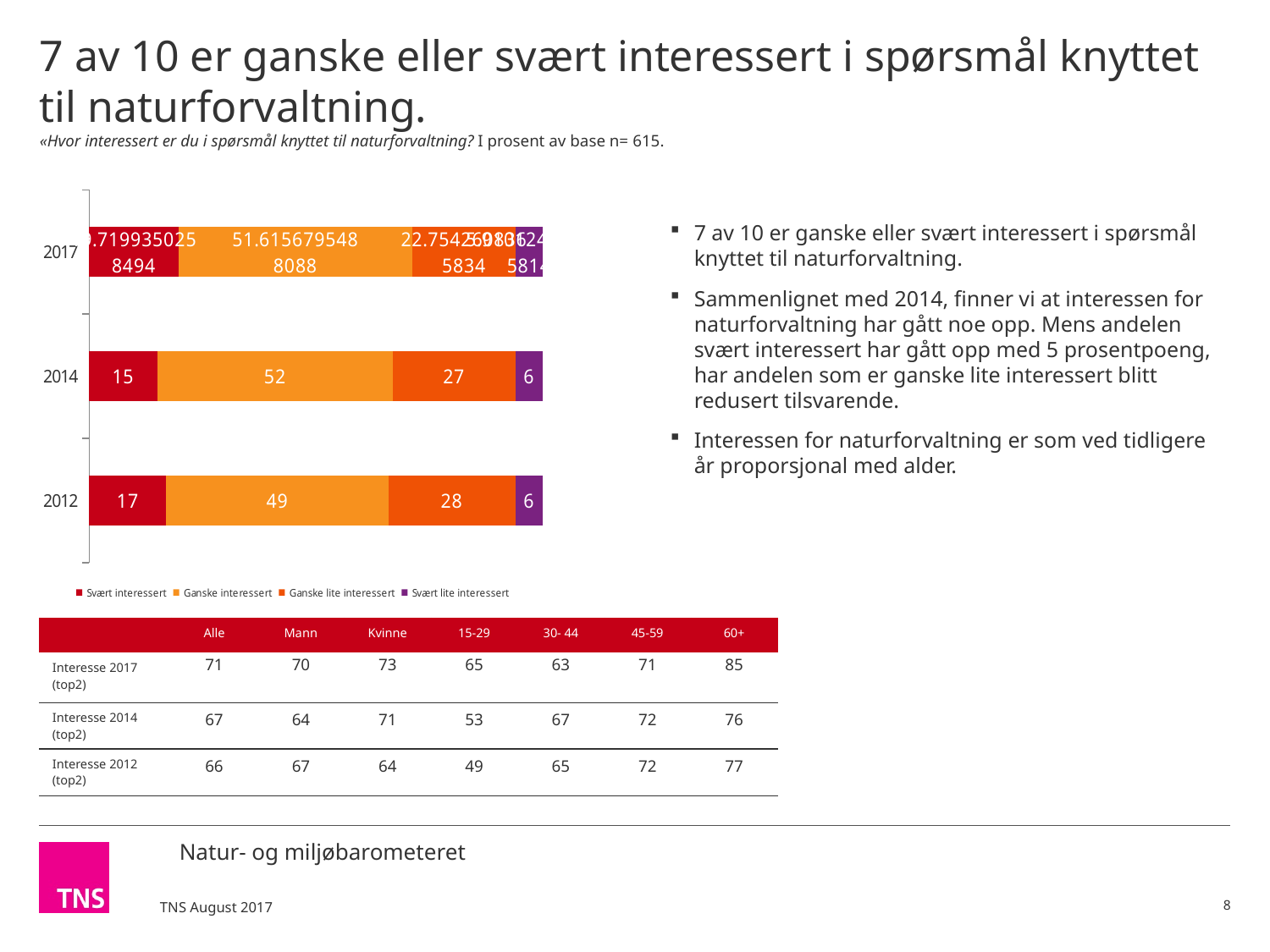
What kind of chart is shown on the slide? Stacked bar chart What is the value for Svært lite interessert in 2012? 6 How many years are shown as bars in the chart? 3 Which series has the largest segment in the 2012 bar? Ganske interessert What is the value for Ganske interessert in 2014? 52 Which year has the larger value for Svært interessert, 2014 or 2012? 2012 What is the value for Svært interessert in 2012? 17 How many series does the legend list? 4 What is the total of the 2014 stacked bar? 100 What is the value for Ganske lite interessert in 2014? 27 What is the difference between the Ganske interessert values for 2014 and 2012? 3 Which series has the smallest segment in the 2014 bar? Svært lite interessert